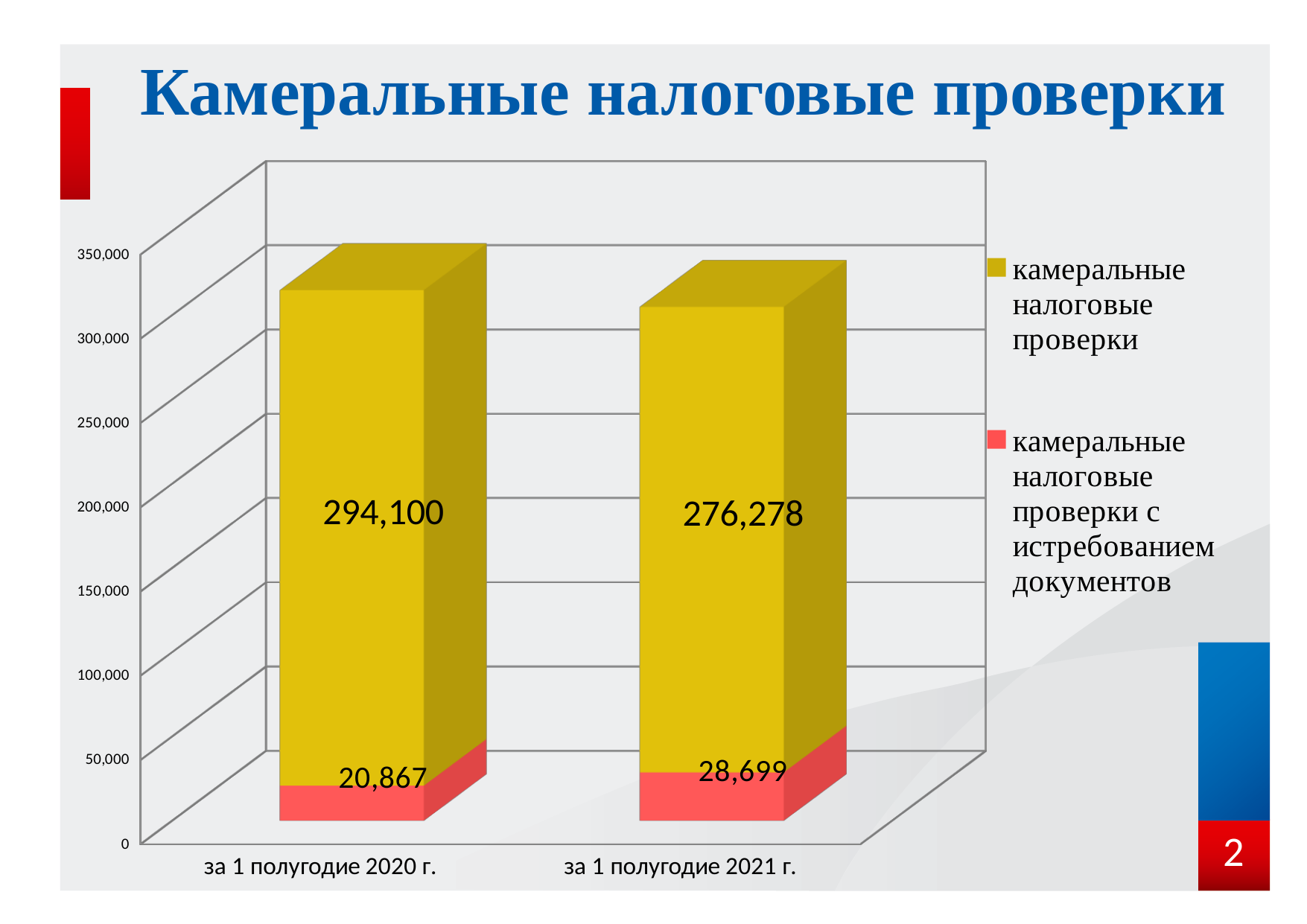
Is the value of камеральные налоговые проверки с истребованием документов larger for 2020 or for 2021? 2021 What is the value of камеральные налоговые проверки с истребованием документов for за 1 полугодие 2020 г.? 20,867 What kind of chart is shown on the slide? Stacked bar chart What is the value of камеральные налоговые проверки for за 1 полугодие 2020 г.? 294,100 Which period has the higher value for камеральные налоговые проверки? за 1 полугодие 2020 г. What is the value of камеральные налоговые проверки с истребованием документов for за 1 полугодие 2021 г.? 28,699 What is the value of камеральные налоговые проверки for за 1 полугодие 2021 г.? 276,278 What is the difference between the камеральные налоговые проверки values for 2020 and 2021? 17,822 What is the difference between the камеральные налоговые проверки с истребованием документов values for 2021 and 2020? 7,832 How many series does the legend list? 2 Which period has the lower value for камеральные налоговые проверки с истребованием документов? за 1 полугодие 2020 г. How many categories are shown on the x axis? 2